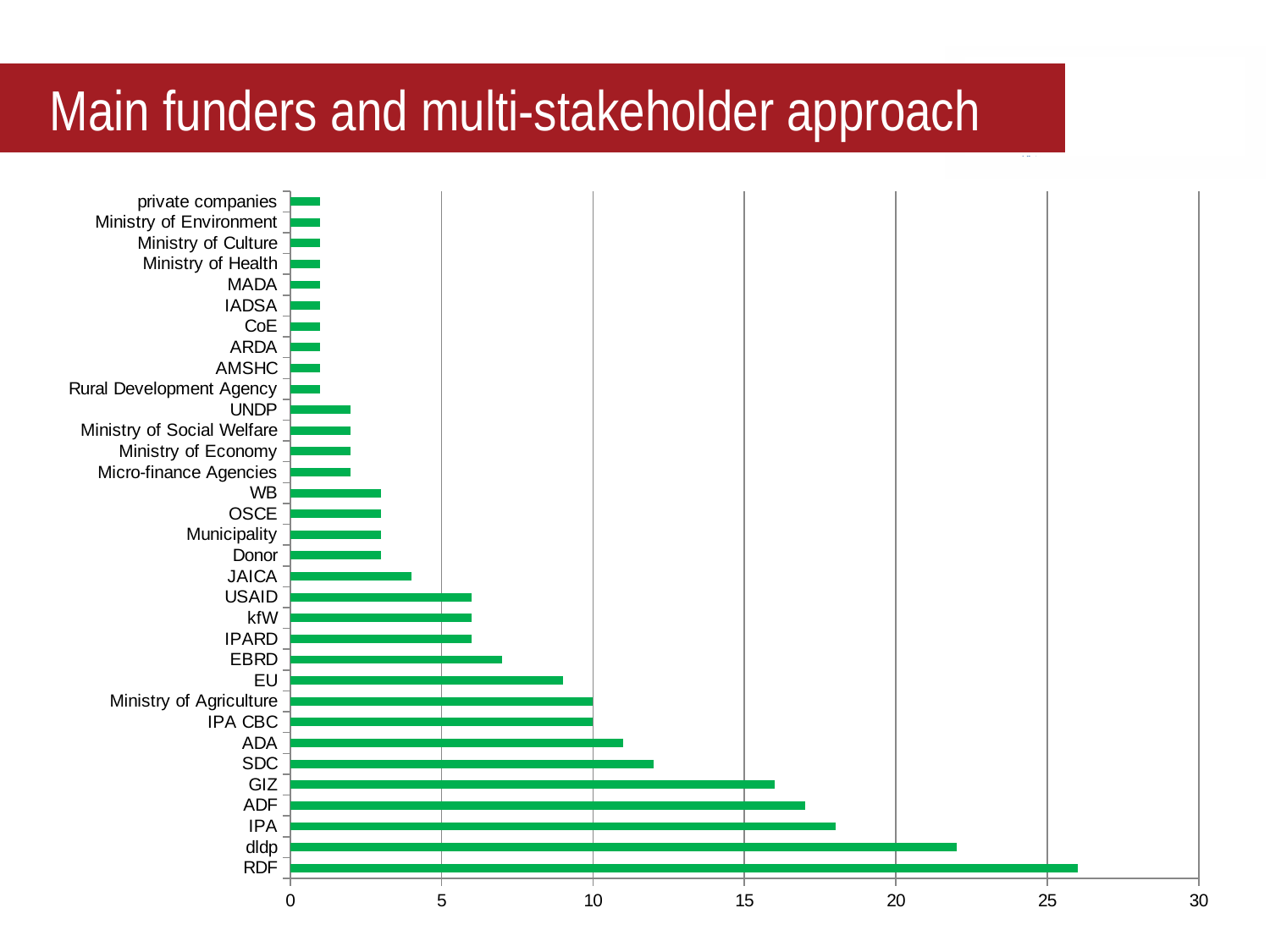
Is the value for EU greater or less than 10? less Is the value for SDC greater or less than 10? greater What kind of chart is shown on the slide? bar chart Which has the larger value, RDF or dldp? RDF How many categories are plotted in the chart? 33 Is the value for IPA greater or less than 20? less Which category has the highest value in the chart? RDF Which has the larger value, GIZ or SDC? GIZ What colour are the bars in the chart? green